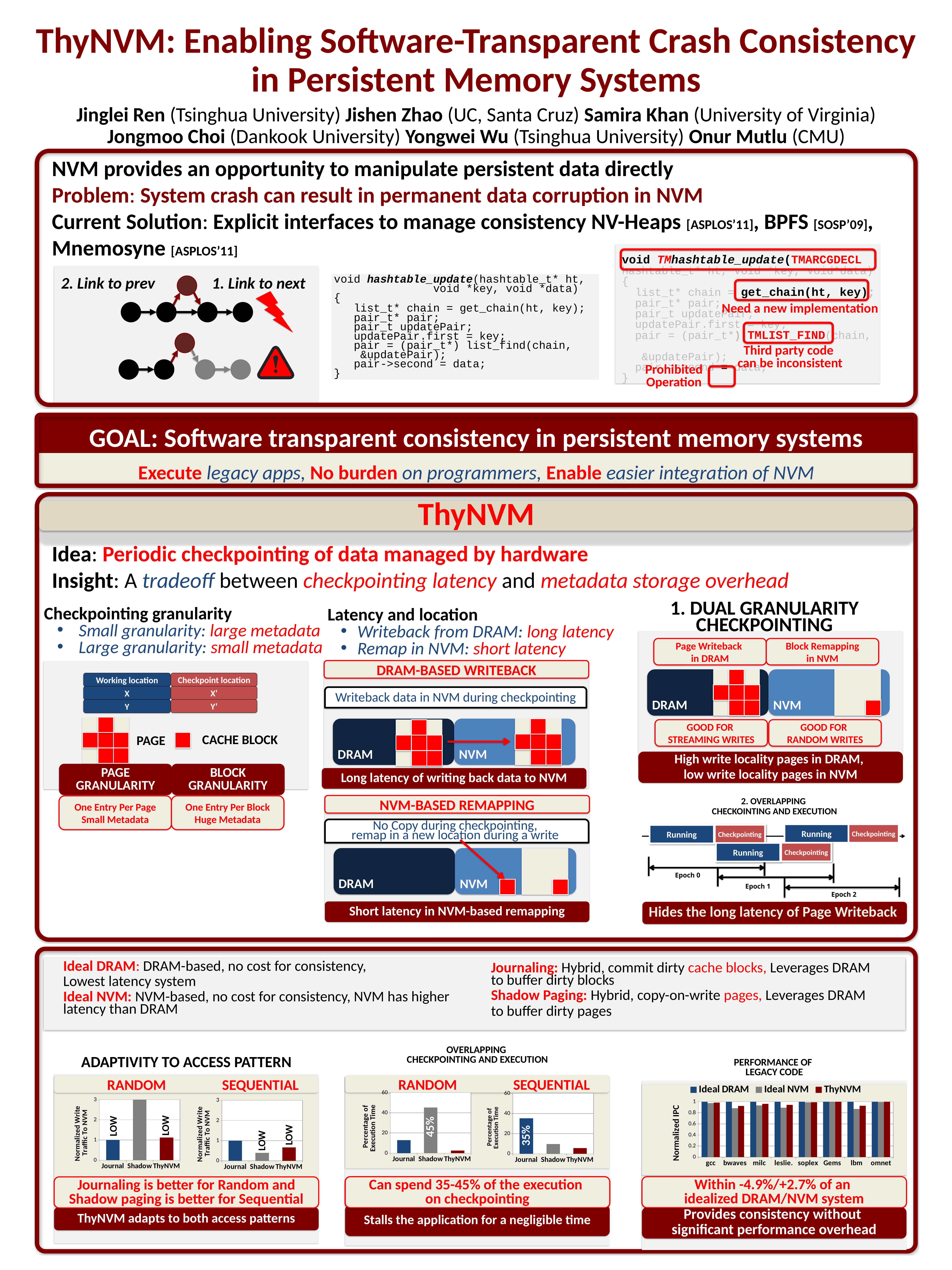
In the 'OVERLAPPING CHECKPOINTING AND EXECUTION' RANDOM chart, which category has the highest percentage of execution time? Shadow In the 'OVERLAPPING CHECKPOINTING AND EXECUTION' RANDOM chart, what percentage of execution time is shown for Shadow? 45% How many benchmark categories are shown on the x axis of the 'PERFORMANCE OF LEGACY CODE' chart? 8 In the 'ADAPTIVITY TO ACCESS PATTERN' RANDOM chart, is the value for Shadow greater or less than 2? greater In the 'OVERLAPPING CHECKPOINTING AND EXECUTION' SEQUENTIAL chart, what percentage of execution time is shown for Journal? 35% What kind of chart is the 'PERFORMANCE OF LEGACY CODE' chart? bar chart In the 'OVERLAPPING CHECKPOINTING AND EXECUTION' RANDOM chart, is the value for Journal greater or less than 20? less What are the legend entries of the 'PERFORMANCE OF LEGACY CODE' chart? Ideal DRAM, Ideal NVM, ThyNVM How many series does the legend of the 'PERFORMANCE OF LEGACY CODE' chart list? 3 In the 'OVERLAPPING CHECKPOINTING AND EXECUTION' SEQUENTIAL chart, which category has the lowest percentage of execution time? ThyNVM In the 'ADAPTIVITY TO ACCESS PATTERN' SEQUENTIAL chart, which is larger, the value for Journal or the value for Shadow? Journal In the 'ADAPTIVITY TO ACCESS PATTERN' RANDOM chart, which category has the highest normalized write traffic to NVM? Shadow